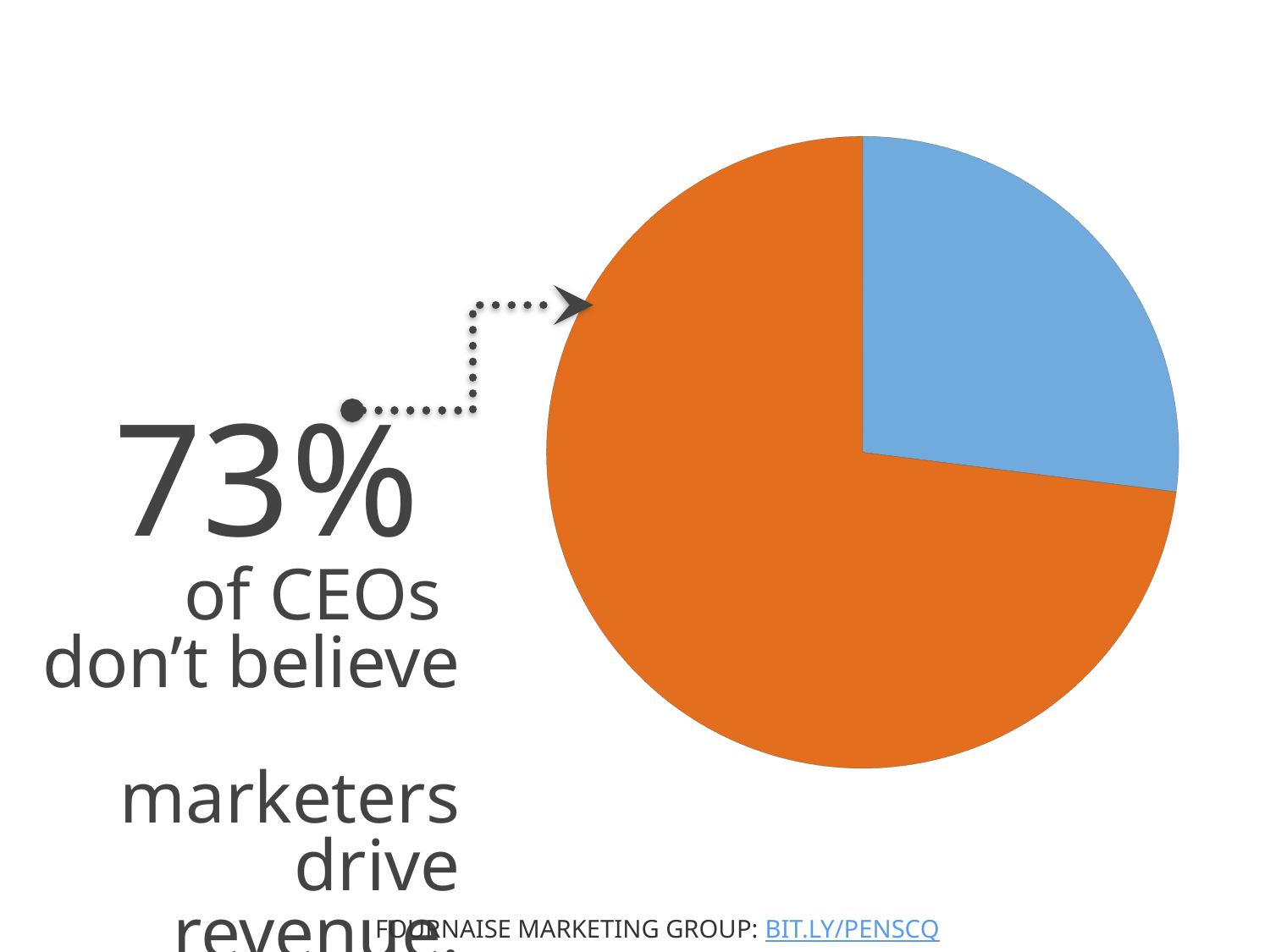
Is the blue slice more or less than half of the pie? less What kind of chart is shown on the slide? pie chart Is the orange slice more or less than half of the pie? more Which slice of the pie chart is the largest? the orange slice What share of the pie does the orange slice represent, according to the figure printed on the slide? 73% How many slices does the pie chart have? 2 What colour is the slice that the dotted arrow from the 73% figure points to? orange Which slice of the pie chart is the smallest? the blue slice Which slice is larger, the orange slice or the blue slice? the orange slice What does the 73% slice of the pie chart represent, according to the slide text? CEOs who don't believe marketers drive revenue